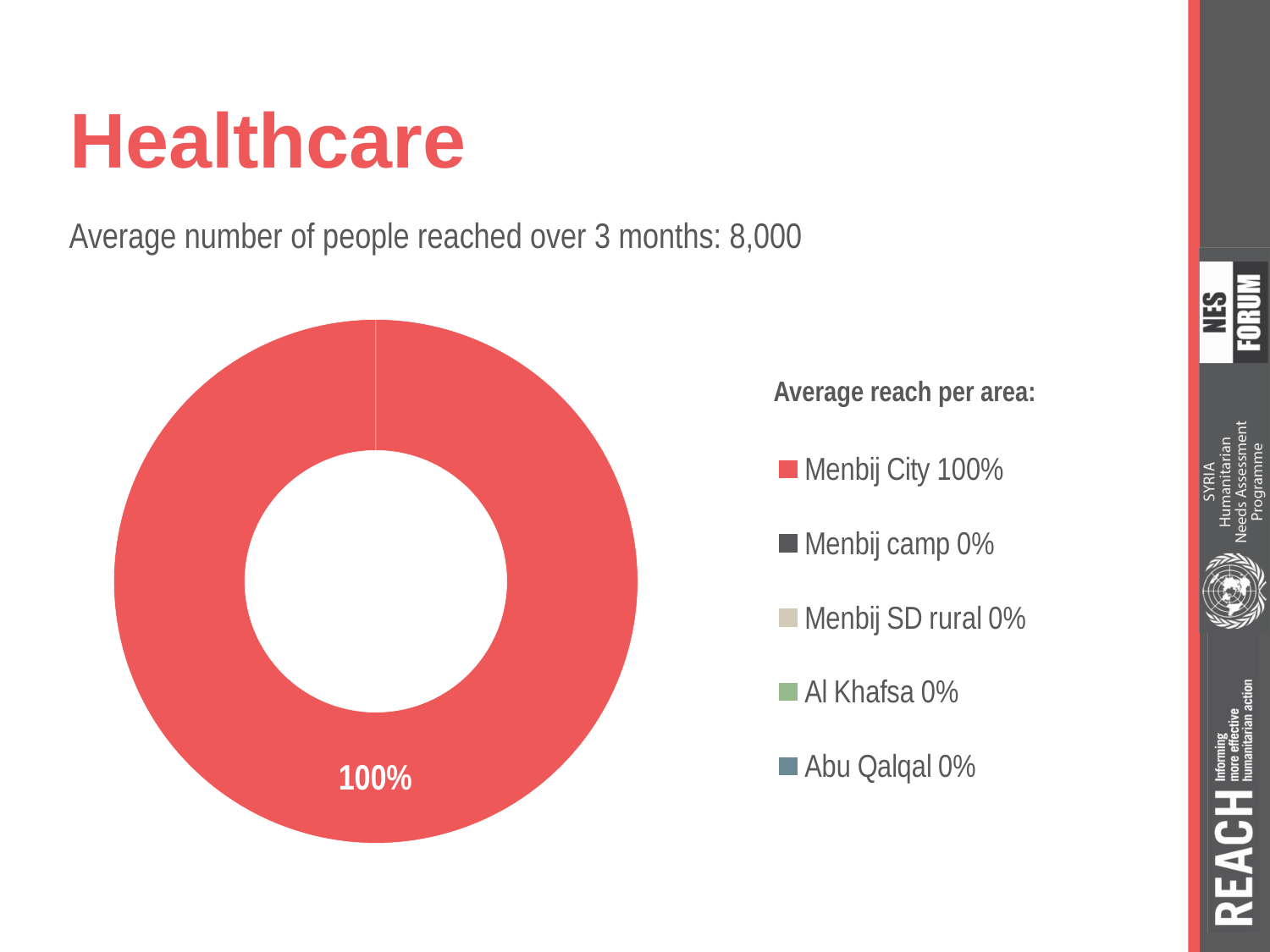
What percentage of the average reach is attributed to Menbij camp? 0% How many areas are listed in the chart's legend? 5 What kind of chart is shown on the slide? donut chart What percentage of the average reach is attributed to Menbij City? 100% Which has a larger share of the average reach, Menbij City or Menbij camp? Menbij City What percentage of the average reach is attributed to Abu Qalqal? 0% What heading appears above the chart's legend? Average reach per area: What percentage of the average reach is attributed to Menbij SD rural? 0% What percentage of the average reach is attributed to Al Khafsa? 0% What is the difference between the shares for Menbij City and Abu Qalqal? 100% Which area has the highest share of the average reach? Menbij City What share of the chart does the Menbij City slice take up? 100%